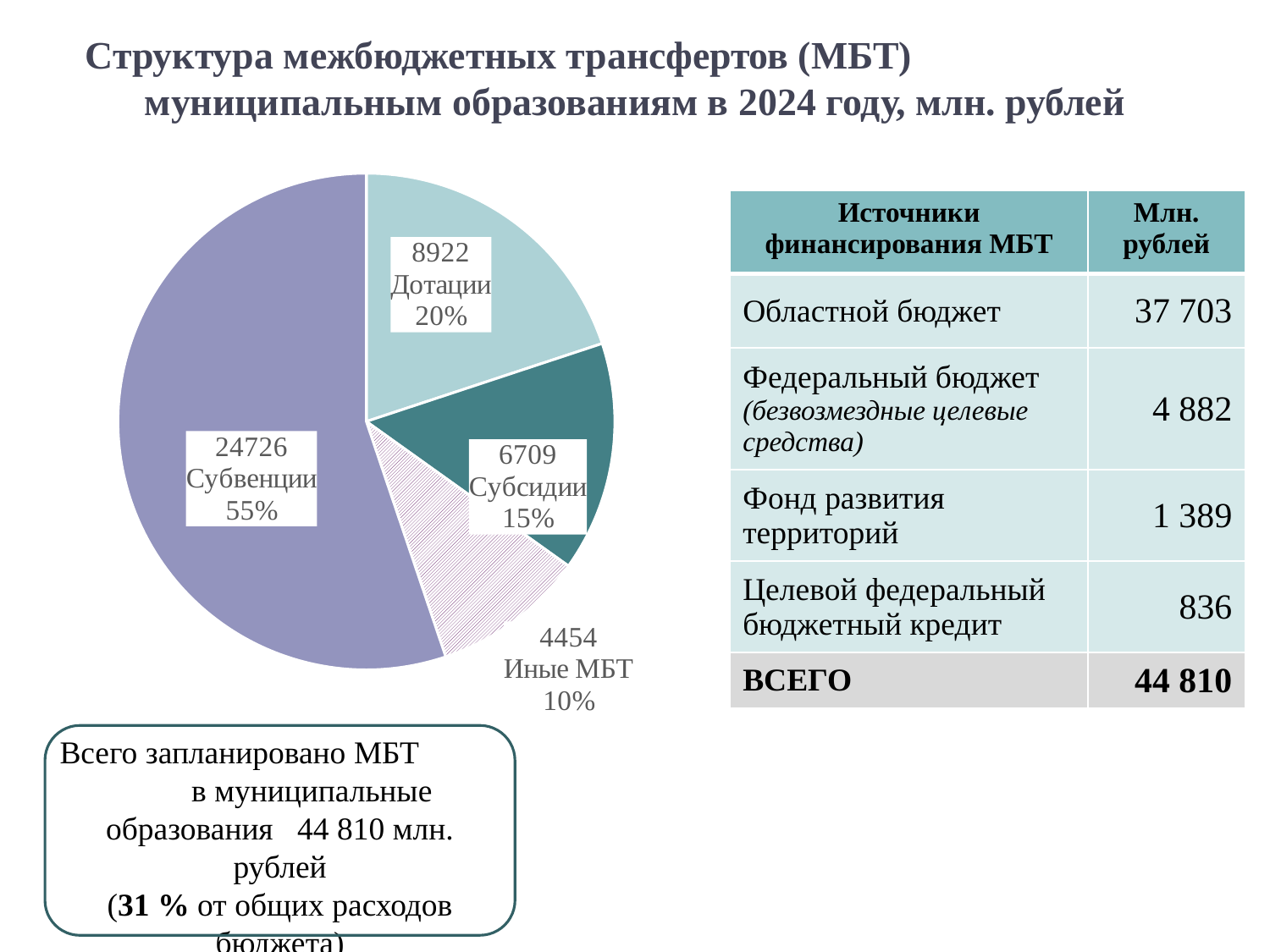
Which category has the smallest slice in the pie chart? Иные МБТ What is the value for Субсидии in the pie chart? 6709 Which is larger in the pie chart, Дотации or Иные МБТ? Дотации What is the value for Иные МБТ in the pie chart? 4454 What share of the pie does Субсидии represent? 15% What is the value for Субвенции in the pie chart? 24726 How many slices does the pie chart have? 4 Which category has the largest slice in the pie chart? Субвенции What is the value for Дотации in the pie chart? 8922 What is the difference between the values for Дотации and Субсидии in the pie chart? 2213 What type of chart is shown on the slide? Pie chart What share of the pie does Субвенции represent? 55%